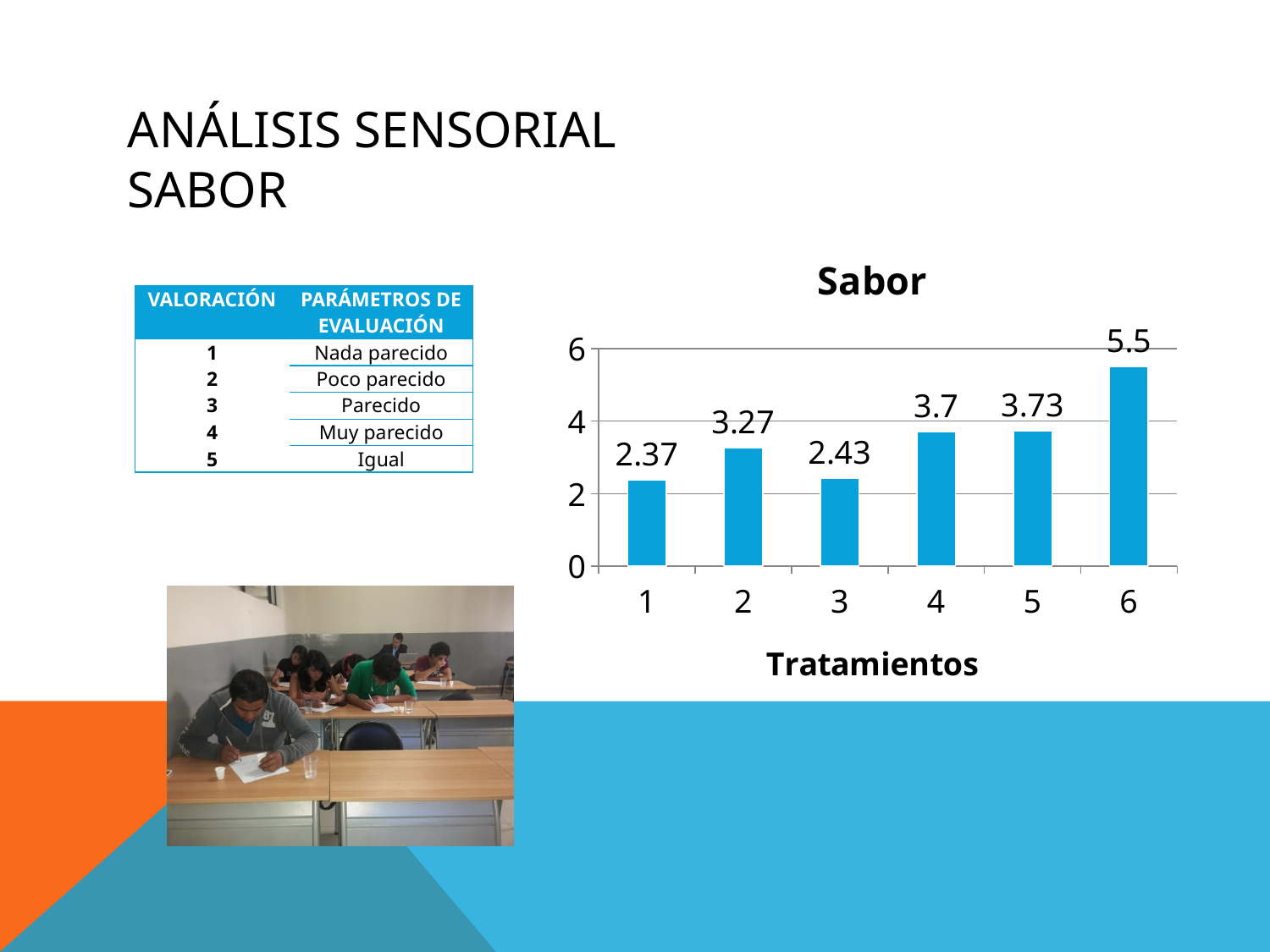
What kind of chart is the Sabor chart? Bar chart Which treatment has the highest value in the Sabor chart? 6 What is the value for treatment 1 in the Sabor chart? 2.37 What is the value for treatment 4 in the Sabor chart? 3.7 Is the value for treatment 5 in the Sabor chart greater or less than 4? less What is the x-axis title of the Sabor chart? Tratamientos How many treatments are shown on the x axis of the Sabor chart? 6 What is the difference between the values for treatment 2 and treatment 3 in the Sabor chart? 0.84 Which has a larger value in the Sabor chart, treatment 2 or treatment 3? Treatment 2 What is the difference between the values for treatment 6 and treatment 1 in the Sabor chart? 3.13 What is the value for treatment 6 in the Sabor chart? 5.5 Which treatment has the lowest value in the Sabor chart? 1